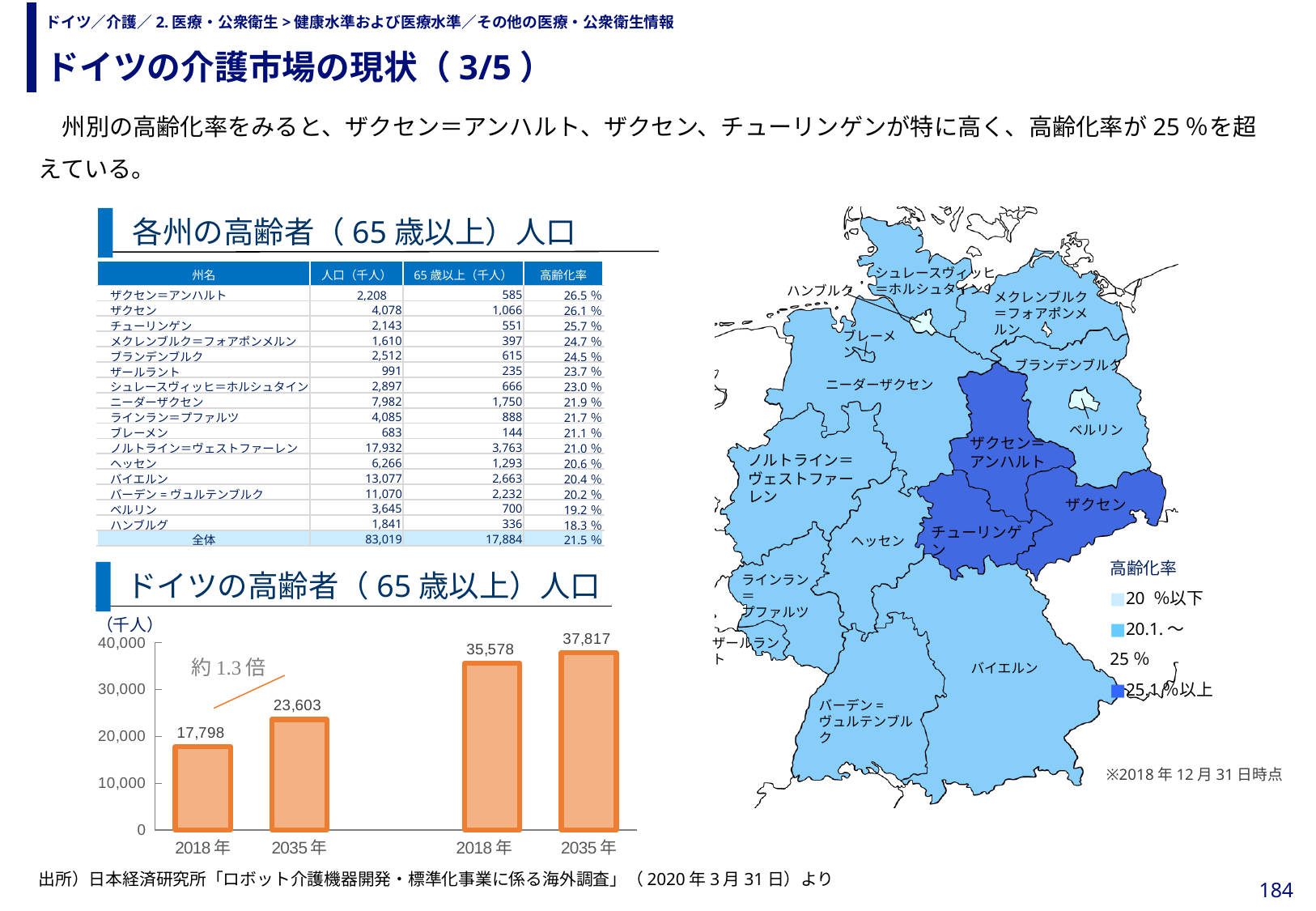
In the 「ドイツの高齢者（65歳以上）人口」 chart, how many bars are plotted? 4 In the 「ドイツの高齢者（65歳以上）人口」 chart, what is the difference between the two bars in the right pair (2035年 minus 2018年)? 2,239 In the 「ドイツの高齢者（65歳以上）人口」 chart, what is the value of the third bar from the left (2018年)? 35,578 In the 「ドイツの高齢者（65歳以上）人口」 chart, which bar has the highest value? the rightmost 2035年 bar (37,817) In the 「ドイツの高齢者（65歳以上）人口」 chart, which bar has the lowest value? the leftmost 2018年 bar (17,798) In the 「ドイツの高齢者（65歳以上）人口」 chart, what unit is shown above the y axis? （千人） What kind of chart is the 「ドイツの高齢者（65歳以上）人口」 chart? bar chart In the 「ドイツの高齢者（65歳以上）人口」 chart, what is the difference between the two bars in the left pair (2035年 minus 2018年)? 5,805 In the 「ドイツの高齢者（65歳以上）人口」 chart, what is the value of the rightmost bar (2035年)? 37,817 In the 「ドイツの高齢者（65歳以上）人口」 chart, what is the value of the leftmost bar (2018年)? 17,798 In the 「ドイツの高齢者（65歳以上）人口」 chart, is the value of the leftmost 2018年 bar greater or less than 20,000? less In the 「ドイツの高齢者（65歳以上）人口」 chart, what is the value of the second bar from the left (2035年)? 23,603